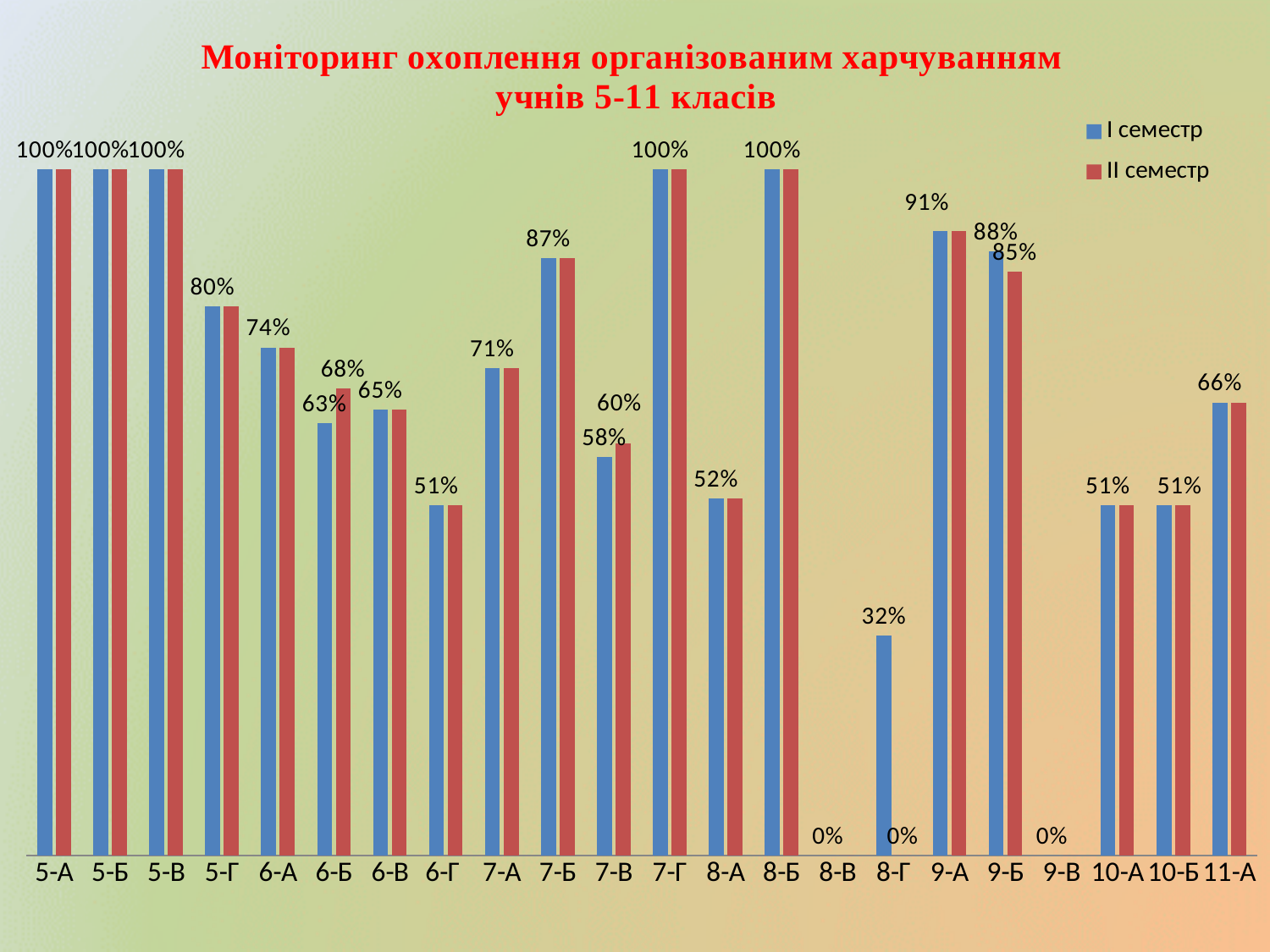
What is the value shown for class 5-Г? 80% How many classes are shown along the x axis? 22 By how many percentage points does the II семестр value for 6-Б exceed the I семестр value? 5 What is the II семестр value for class 8-Г? 0% How many series does the legend list? 2 Which class has the higher value, 9-А or 11-А? 9-А What is the I семестр value for class 8-Г? 32% What is the value shown for class 7-А? 71% What is the II семестр value for class 9-Б? 85% What kind of chart is shown on the slide? Bar chart Which classes show 0% for both semesters? 8-В and 9-В What are the two entries in the legend? I семестр and II семестр